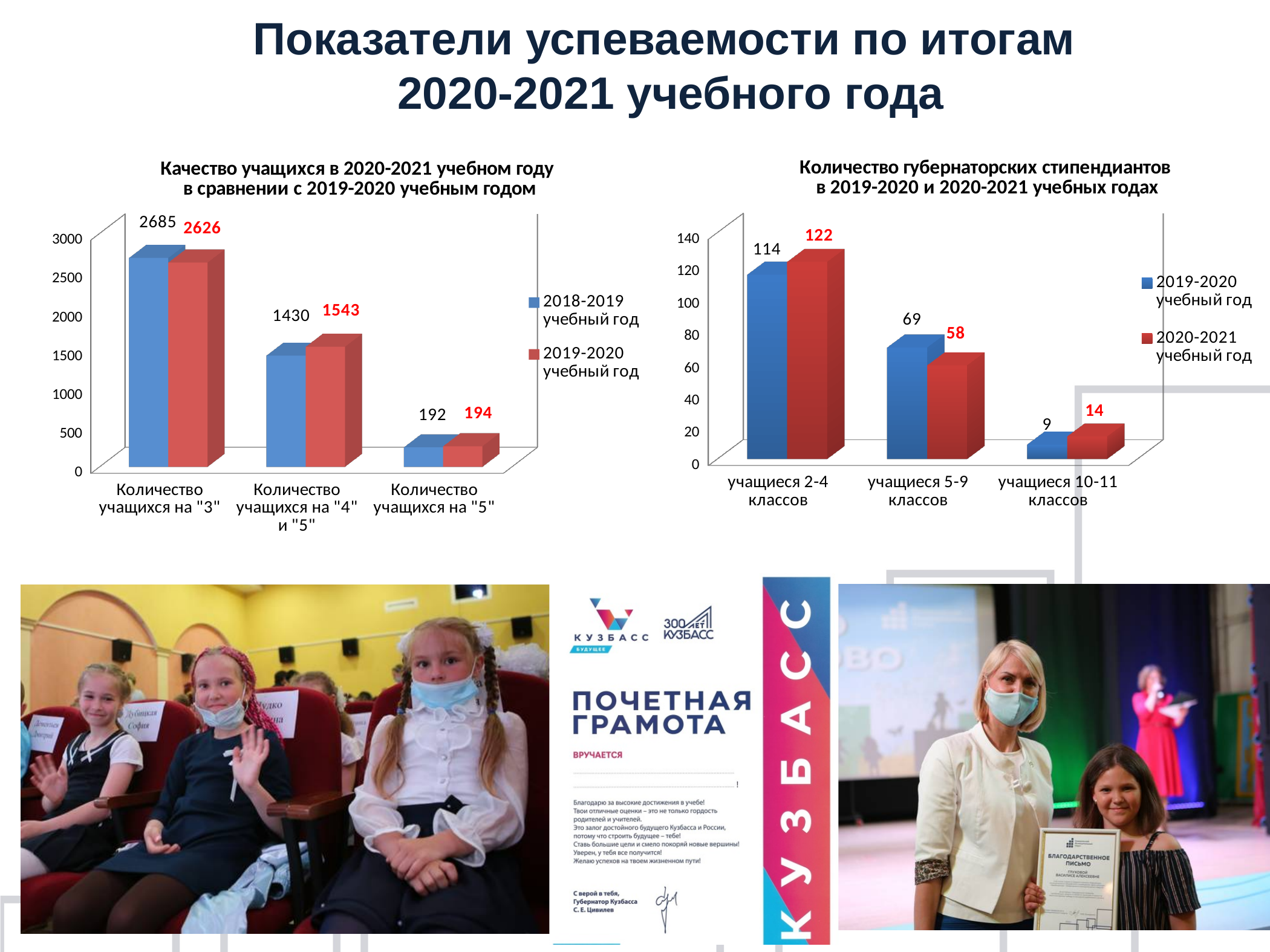
In the left chart (Качество учащихся), what is the value for Количество учащихся на "4" и "5" in the 2019-2020 учебный год series? 1543 In the right chart (Количество губернаторских стипендиантов), which is larger for учащиеся 5-9 классов: the 2019-2020 учебный год value or the 2020-2021 учебный год value? 2019-2020 учебный год In the left chart (Качество учащихся), which category has the highest values? Количество учащихся на "3" In the left chart (Качество учащихся), what is the value for Количество учащихся на "3" in the 2018-2019 учебный год series? 2685 In the right chart (Количество губернаторских стипендиантов), what is the difference between the 2020-2021 and 2019-2020 values for учащиеся 10-11 классов? 5 In the left chart (Качество учащихся), what is the difference between the two series for Количество учащихся на "5"? 2 In the left chart (Качество учащихся), how many series does the legend list? 2 In the right chart (Количество губернаторских стипендиантов), what is the value for учащиеся 2-4 классов in the 2020-2021 учебный год series? 122 What type of chart is the left chart (Качество учащихся)? Bar chart In the right chart (Количество губернаторских стипендиантов), which category has the lowest values? учащиеся 10-11 классов How many categories are shown on the x axis of the right chart (Количество губернаторских стипендиантов)? 3 In the right chart (Количество губернаторских стипендиантов), what is the value for учащиеся 5-9 классов in the 2019-2020 учебный год series? 69